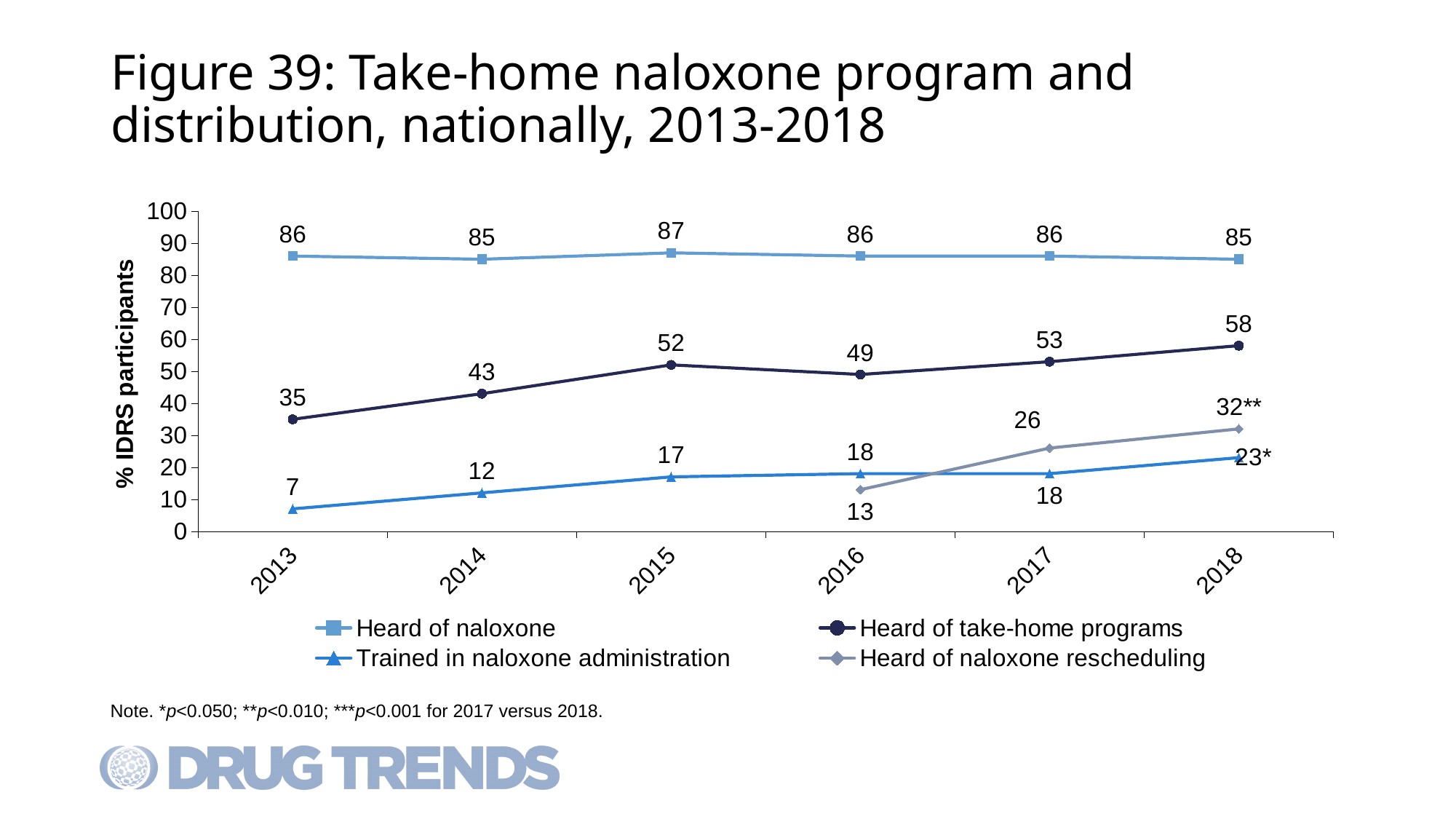
What type of chart is shown on the slide? line chart Does 'Heard of take-home programs' rise or fall from 2013 to 2018 overall? rise What is the value for 'Heard of take-home programs' in 2015? 52 What is the value for 'Trained in naloxone administration' in 2013? 7 What is the label of the y axis? % IDRS participants How many series does the legend list? 4 Which is larger in 2018: 'Heard of naloxone rescheduling' or 'Trained in naloxone administration'? Heard of naloxone rescheduling How many years are shown on the x axis? 6 What is the difference between 'Heard of take-home programs' in 2018 and 2013? 23 What is the value for 'Heard of naloxone rescheduling' in 2017? 26 In which year is 'Heard of naloxone' highest? 2015 In which year is 'Heard of take-home programs' lowest? 2013